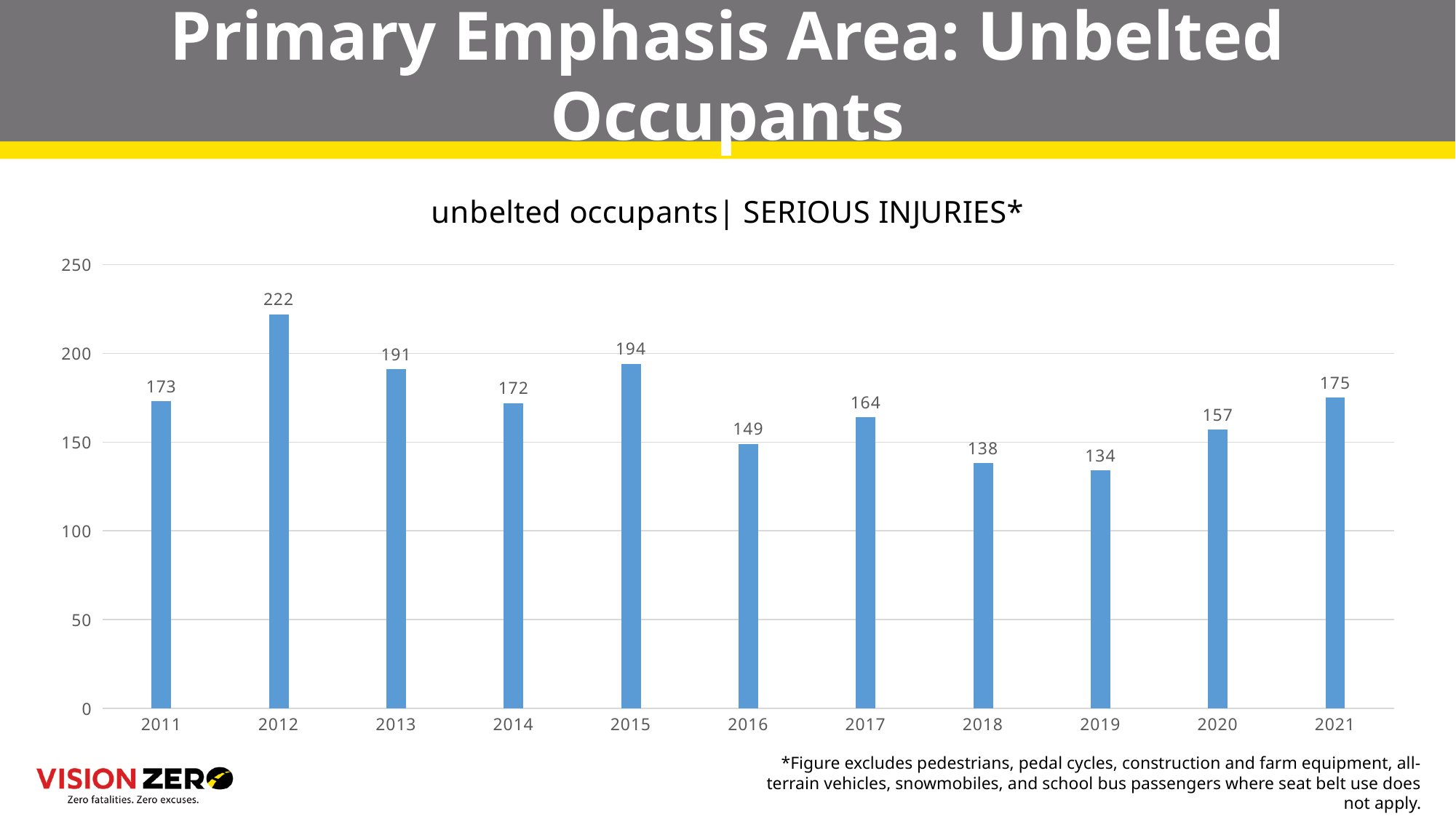
Is the value for 2016 greater or less than 150? less Which year has the highest value? 2012 What is the title of the chart? unbelted occupants| SERIOUS INJURIES* What is the value for 2019? 134 What is the difference between the values for 2012 and 2019? 88 What is the value for 2012? 222 What kind of chart is this? bar chart What is the value for 2021? 175 Which is larger, the value for 2013 or the value for 2015? 2015 Which year has the lowest value? 2019 How many years are shown on the x axis? 11 Do the values rise or fall from 2015 to 2019? fall